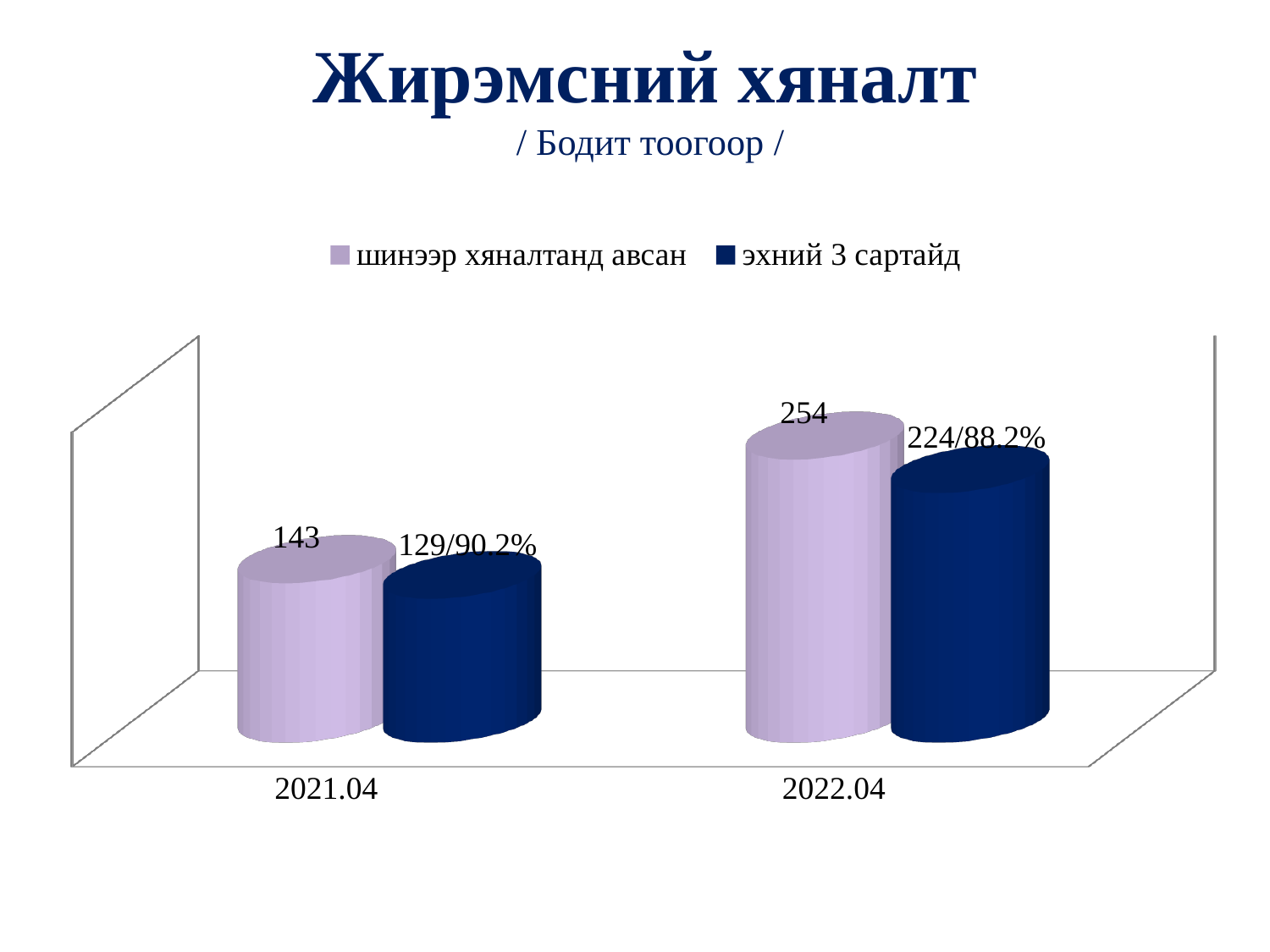
What is the value for "шинээр хяналтанд авсан" in 2021.04? 143 Which year has the higher value for "шинээр хяналтанд авсан"? 2022.04 In 2021.04, which series has the larger value: "шинээр хяналтанд авсан" or "эхний 3 сартайд"? шинээр хяналтанд авсан What is the difference between the two series' counts in 2022.04 (254 and 224)? 30 How many series does the legend list? 2 What kind of chart is shown on the slide? Bar chart How many categories are shown on the x axis? 2 What data label is shown for "эхний 3 сартайд" in 2022.04? 224/88.2% Which year has the lower value for "эхний 3 сартайд"? 2021.04 What data label is shown for "эхний 3 сартайд" in 2021.04? 129/90.2% By how much did "шинээр хяналтанд авсан" increase from 2021.04 to 2022.04? 111 What is the value for "шинээр хяналтанд авсан" in 2022.04? 254